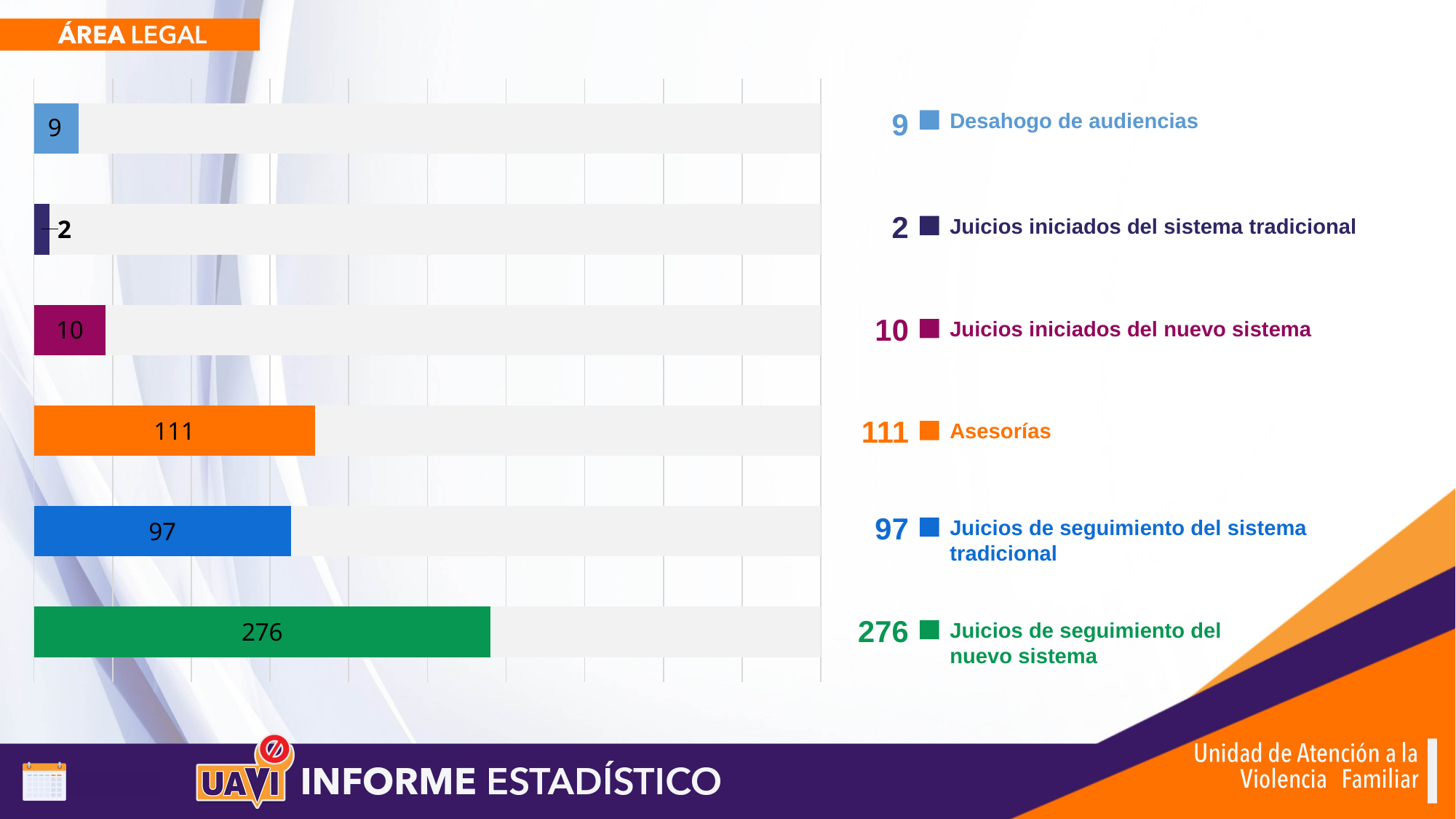
What is the difference between Juicios de seguimiento del nuevo sistema and Juicios de seguimiento del sistema tradicional? 179 How many categories are shown in the chart? 6 Which category has the lowest value? Juicios iniciados del sistema tradicional What is the value for Desahogo de audiencias? 9 Which is larger, Asesorías or Juicios de seguimiento del sistema tradicional? Asesorías What is the value for Asesorías? 111 What is the title shown in the orange box at the top of the slide? ÁREA LEGAL What is the value for Juicios iniciados del sistema tradicional? 2 What is the value for Juicios de seguimiento del sistema tradicional? 97 What kind of chart is shown on the slide? bar chart Which category has the highest value? Juicios de seguimiento del nuevo sistema What is the difference between Juicios iniciados del nuevo sistema and Desahogo de audiencias? 1